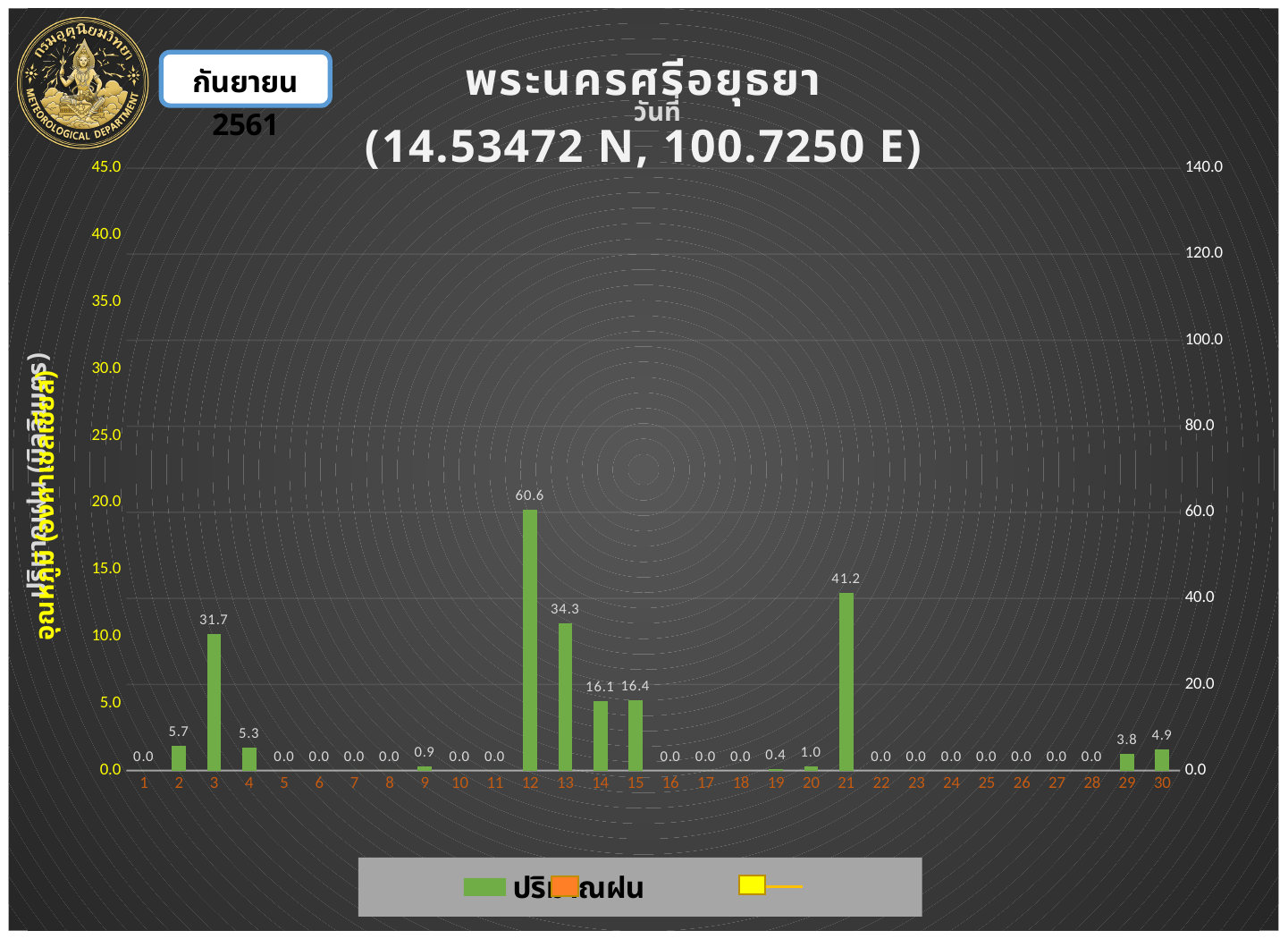
What is the rainfall value shown for day 29? 3.8 What is the rainfall value shown for day 12? 60.6 What kind of chart is shown on the slide? bar chart Which day has the highest rainfall value? 12 Is the rainfall value for day 13 greater or less than 20.0 on the right axis? greater What is the rainfall value shown for day 3? 31.7 How many days are shown on the x axis? 30 What is the difference between the rainfall values for day 13 and day 3? 2.6 What coordinates are given in the chart title? 14.53472 N, 100.7250 E Which has the larger rainfall value, day 14 or day 15? 15 What is the difference between the rainfall values for day 12 and day 21? 19.4 What is the rainfall value shown for day 21? 41.2